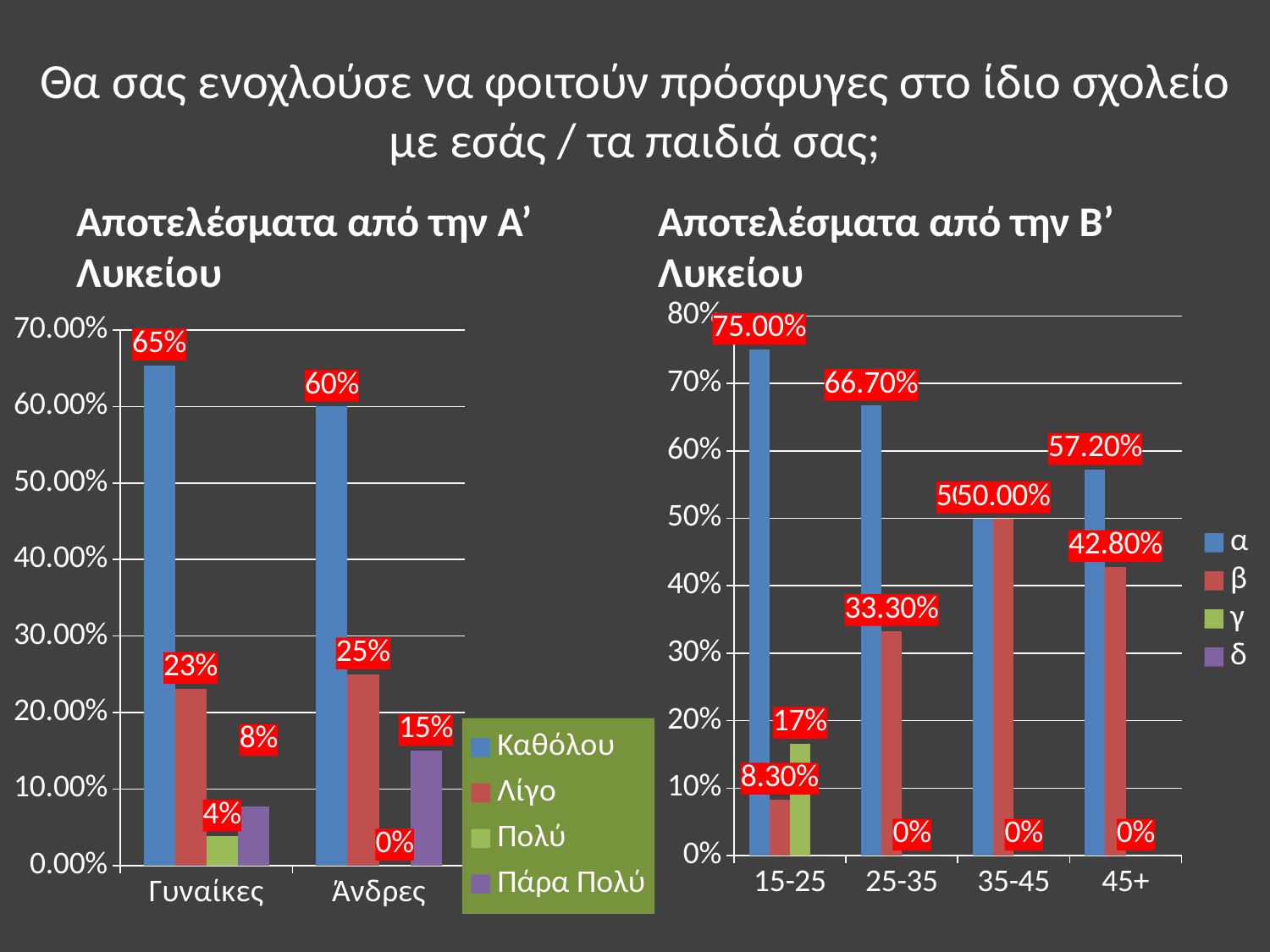
In the chart titled 'Αποτελέσματα από την Α' Λυκείου', what is the value of Πάρα Πολύ for Άνδρες? 15% In the chart titled 'Αποτελέσματα από την Α' Λυκείου', what is the value of Καθόλου for Γυναίκες? 65% In the chart titled 'Αποτελέσματα από την Α' Λυκείου', what is the difference between the Καθόλου values for Γυναίκες and Άνδρες? 5% In the chart titled 'Αποτελέσματα από την Α' Λυκείου', what is the value of Λίγο for Άνδρες? 25% In the chart titled 'Αποτελέσματα από την Α' Λυκείου', how many series does the legend list? 4 What kind of chart is the one titled 'Αποτελέσματα από την Β' Λυκείου'? bar chart In the chart titled 'Αποτελέσματα από την Β' Λυκείου', what is the value of α for the 45+ group? 57.20% In the chart titled 'Αποτελέσματα από την Β' Λυκείου', which age group has the highest value for α? 15-25 In the chart titled 'Αποτελέσματα από την Β' Λυκείου', what is the value of β for the 25-35 group? 33.30% In the chart titled 'Αποτελέσματα από την Β' Λυκείου', how many age groups are shown on the x axis? 4 In the chart titled 'Αποτελέσματα από την Β' Λυκείου', what is the value of α for the 15-25 group? 75.00% In the chart titled 'Αποτελέσματα από την Β' Λυκείου', which is larger for the 45+ group, α or β? α